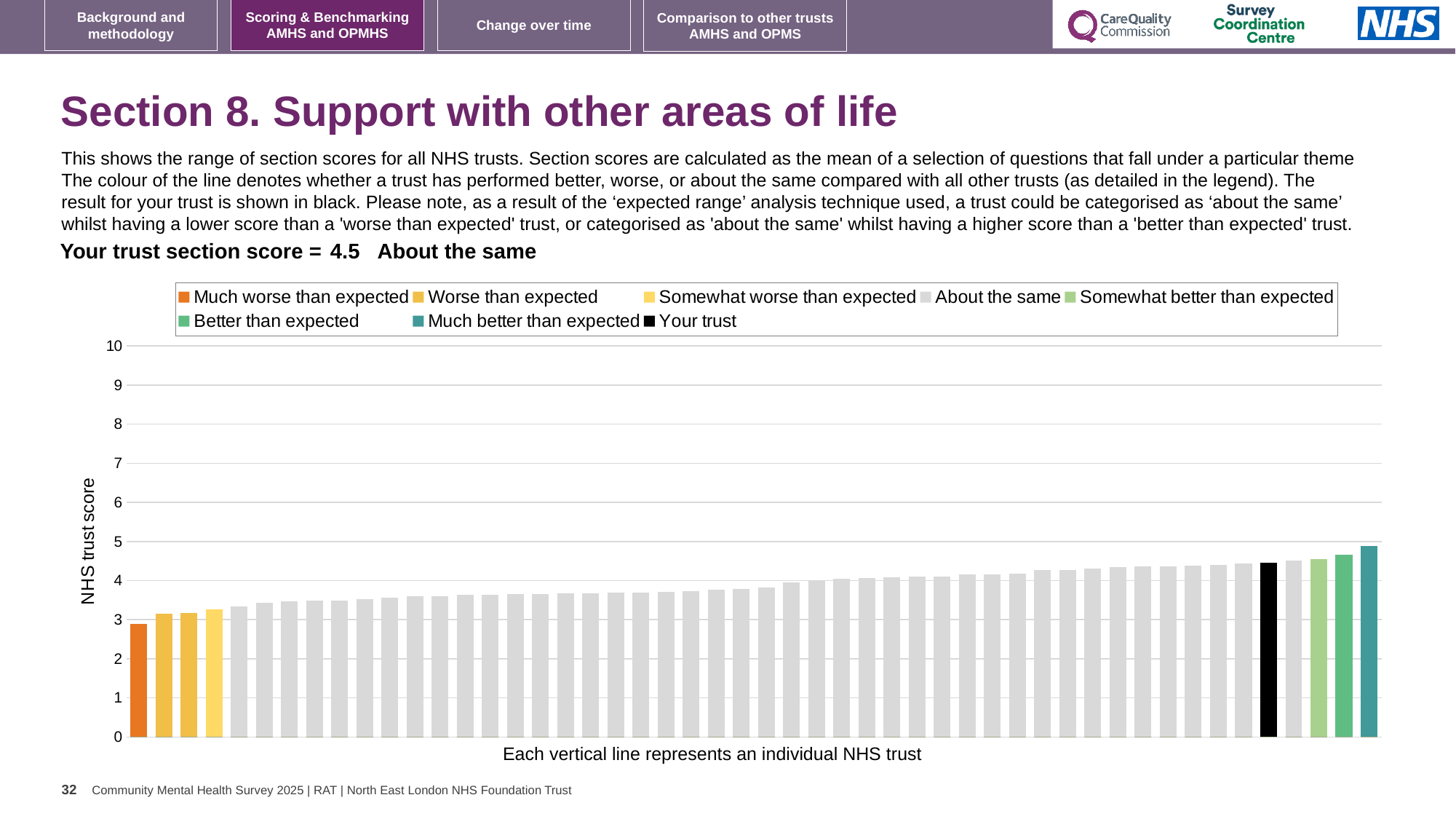
According to the slide, which performance category is your trust in? About the same How many entries does the chart legend list? 8 How many bars are coloured as 'Worse than expected'? 2 Which legend category does the highest bar on the chart belong to? Much better than expected Do the bar values rise or fall from left to right along the x axis? rise What kind of chart is shown on the slide? bar chart Which legend category does the lowest bar on the chart belong to? Much worse than expected Is the value for the leftmost (orange) bar greater or less than 3? less Is the value for the rightmost (teal) bar greater or less than 4? greater Is the value for the black 'Your trust' bar greater or less than 4? greater What is the label on the y axis of the chart? NHS trust score What is the section score for your trust shown on the slide? 4.5